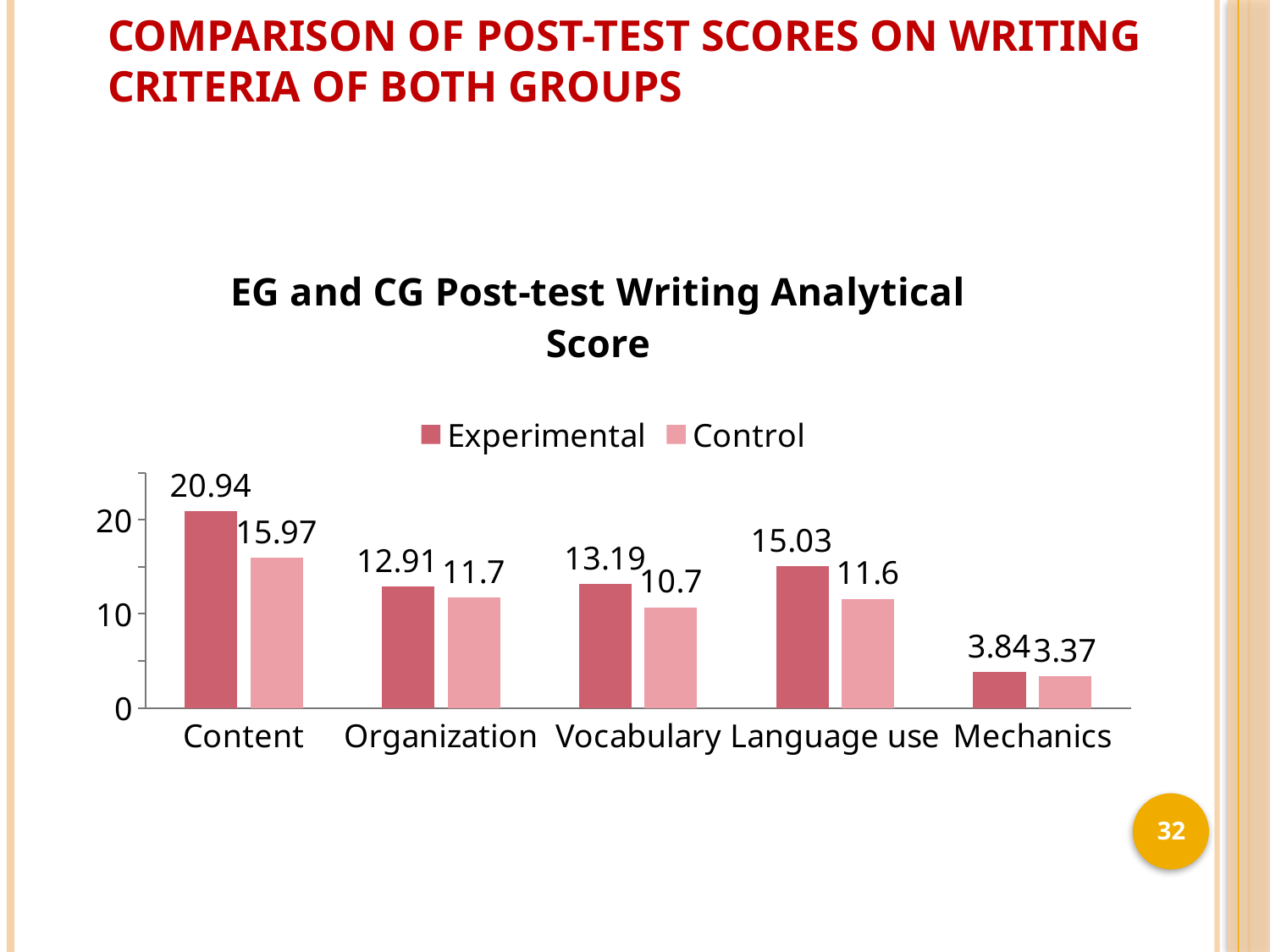
What kind of chart is shown? bar chart What is the Control group's score for Mechanics? 3.37 What is the difference between the Experimental and Control scores for Language use? 3.43 What is the difference between the Experimental and Control scores for Content? 4.97 Is the Control score for Content greater or less than 10? greater Which is larger, the Experimental score for Organization or the Experimental score for Vocabulary? Vocabulary What is the Control group's score for Vocabulary? 10.7 Which criterion has the lowest Control score? Mechanics How many writing criteria are shown on the x axis? 5 How many series does the legend list? 2 What is the Experimental group's score for Content? 20.94 Which criterion has the highest Experimental score? Content